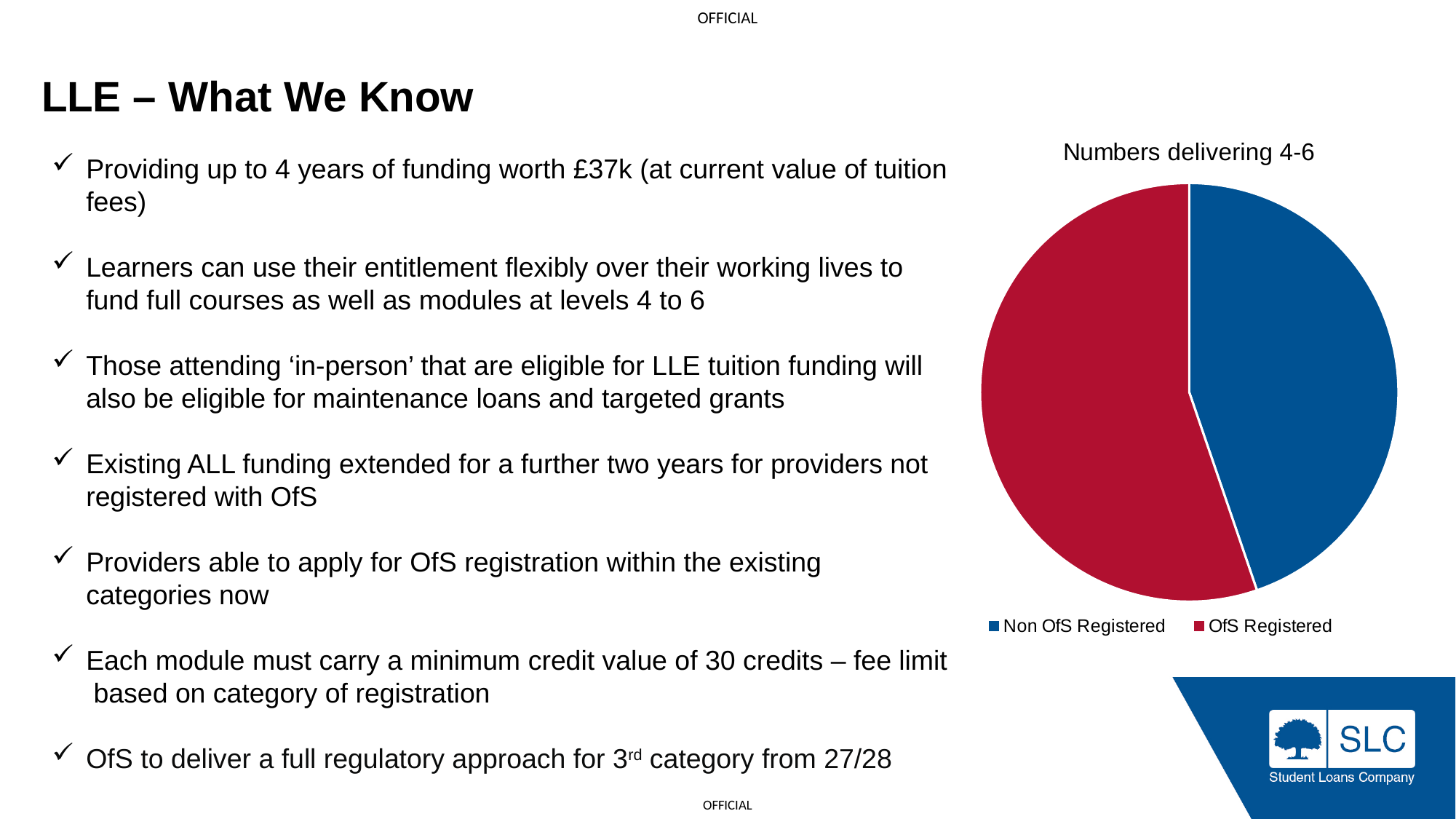
What colour represents Non OfS Registered in the pie chart? blue Is the slice for OfS Registered larger or smaller than the slice for Non OfS Registered? larger What kind of chart is shown on the slide? pie chart Which category has the larger slice in the pie chart? OfS Registered What is the title of the chart on the slide? Numbers delivering 4-6 How many entries does the chart legend list? 2 Which category has the smaller slice in the pie chart? Non OfS Registered How many slices does the pie chart have? 2